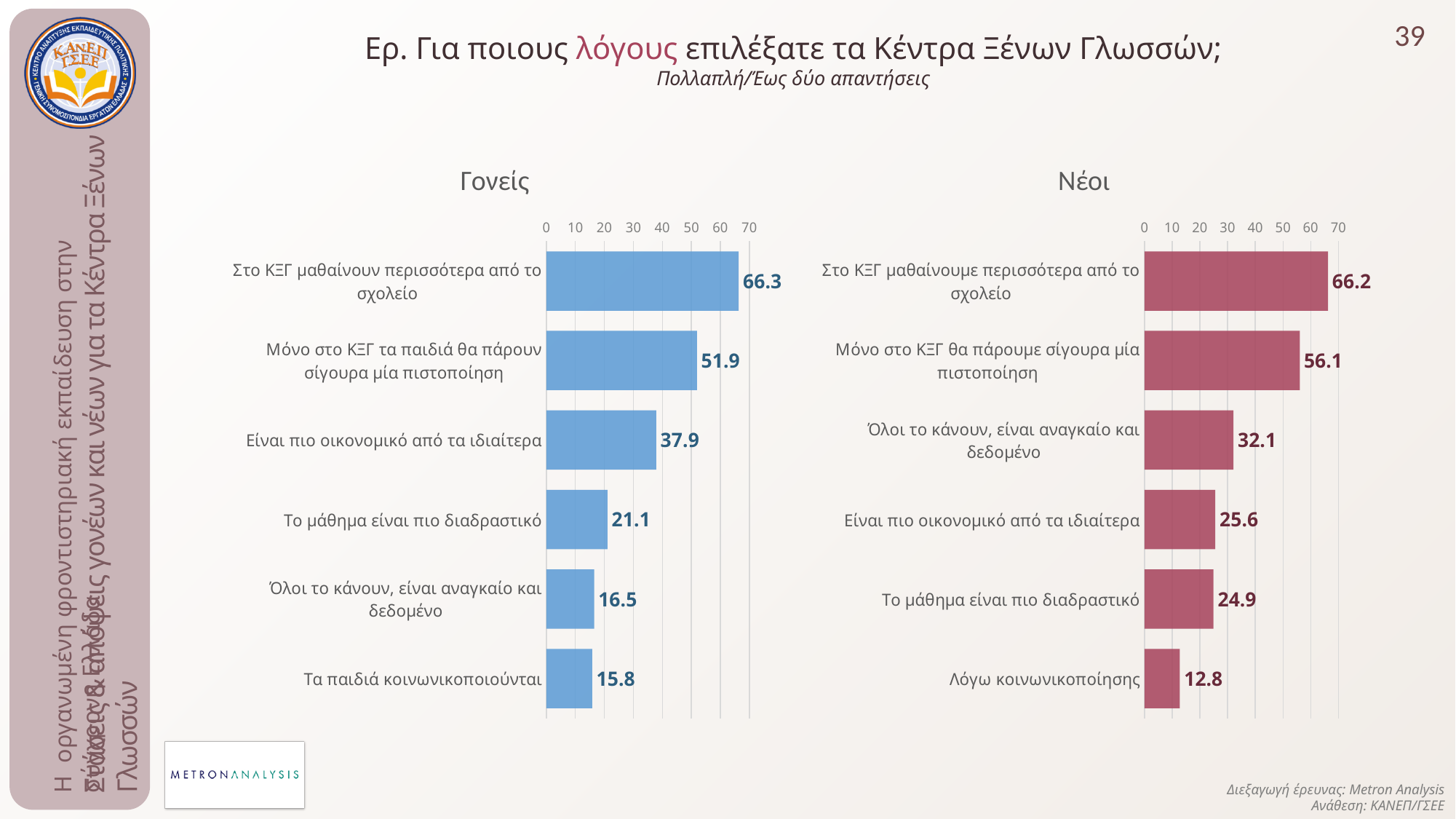
What kind of chart is the Νέοι chart? bar chart In the Νέοι chart, what is the difference between 'Όλοι το κάνουν, είναι αναγκαίο και δεδομένο' and 'Λόγω κοινωνικοποίησης'? 19.3 In the Γονείς chart, what is the value for 'Είναι πιο οικονομικό από τα ιδιαίτερα'? 37.9 In the Γονείς chart, which category has the highest value? Στο ΚΞΓ μαθαίνουν περισσότερα από το σχολείο What is the title of the chart on the right side of the slide? Νέοι In the Νέοι chart, what is the value for 'Μόνο στο ΚΞΓ θα πάρουμε σίγουρα μία πιστοποίηση'? 56.1 How many categories does the Γονείς chart show? 6 In the Νέοι chart, which category has the lowest value? Λόγω κοινωνικοποίησης Which is larger: 'Είναι πιο οικονομικό από τα ιδιαίτερα' in the Γονείς chart or in the Νέοι chart? Γονείς In the Νέοι chart, is the value for 'Είναι πιο οικονομικό από τα ιδιαίτερα' greater or less than 30? less In the Γονείς chart, what is the value for 'Τα παιδιά κοινωνικοποιούνται'? 15.8 In the Γονείς chart, what is the difference between 'Στο ΚΞΓ μαθαίνουν περισσότερα από το σχολείο' and 'Μόνο στο ΚΞΓ τα παιδιά θα πάρουν σίγουρα μία πιστοποίηση'? 14.4